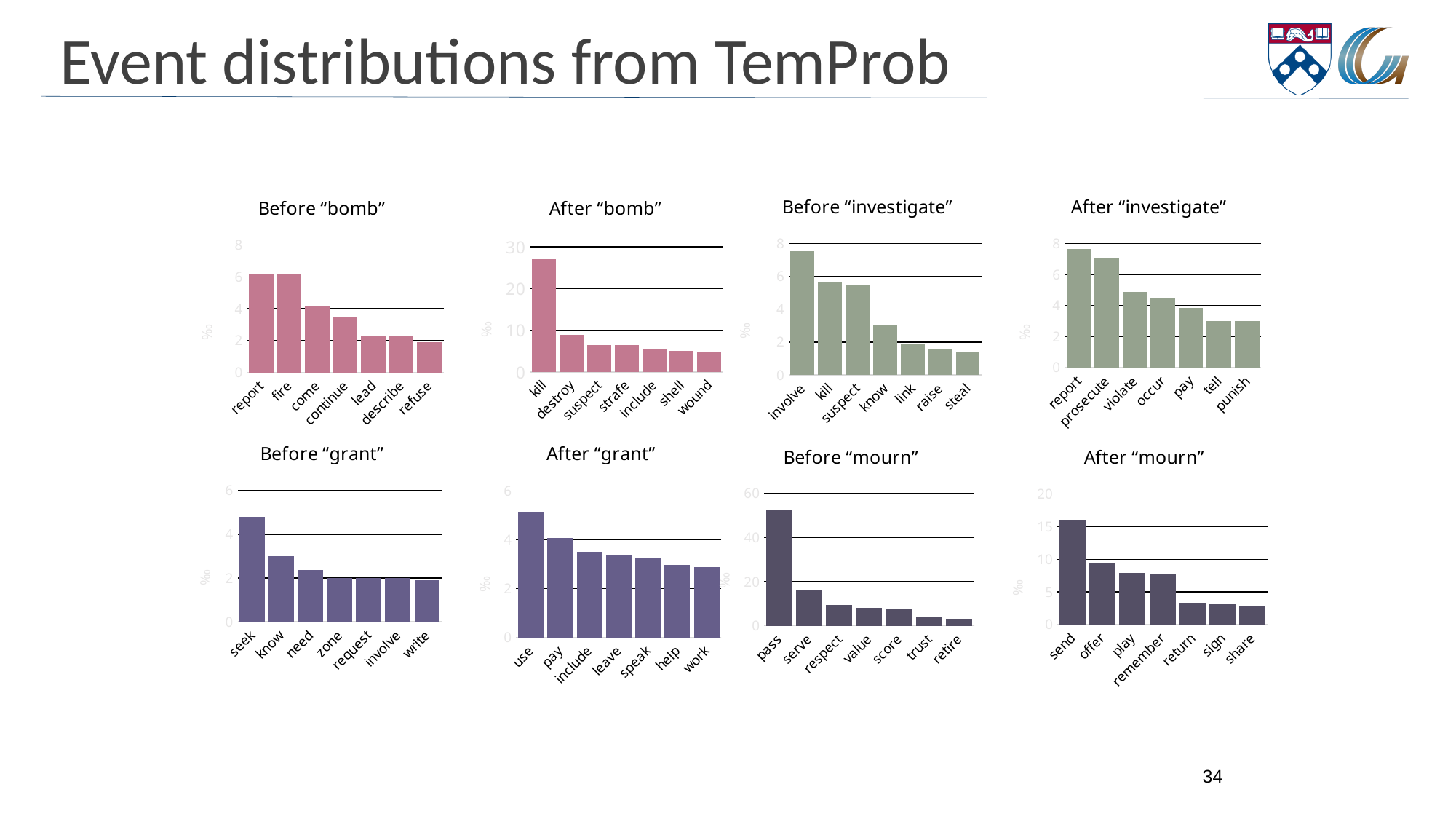
In the After "bomb" chart, is the value for kill greater or less than 20? greater In the Before "mourn" chart, is the value for pass greater or less than 40? greater In the After "mourn" chart, which is larger, the value for send or the value for offer? send In the After "mourn" chart, do the values rise or fall from left to right along the x axis? fall How many categories are shown in the Before "investigate" chart? 7 In the Before "grant" chart, which category has the highest value? seek In the Before "mourn" chart, which category has the highest value? pass In the After "grant" chart, which category has the highest value? use In the Before "grant" chart, is the value for seek greater or less than 4? greater What kind of chart is the Before "bomb" chart? bar chart